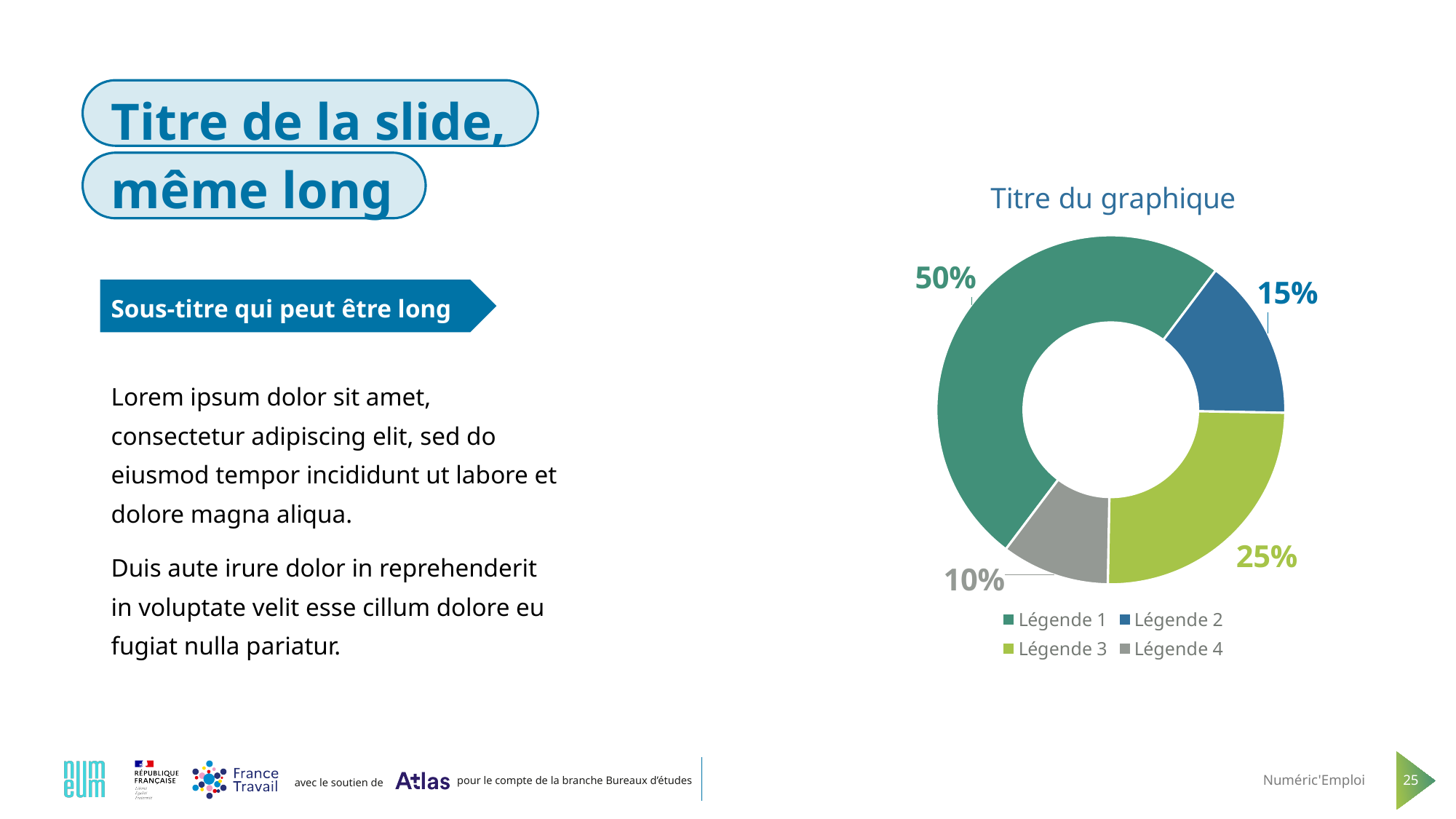
What colour is the slice for Légende 4? Grey What is the value for Légende 2? 15% Which is larger, the value for Légende 2 or the value for Légende 3? Légende 3 Which category has the largest share of the chart? Légende 1 What is the title of the chart? Titre du graphique What type of chart is shown on the slide? Doughnut chart Which category has the smallest share of the chart? Légende 4 What is the value for Légende 4? 10% What is the value for Légende 1? 50% What is the difference between the values for Légende 1 and Légende 3? 25% How many categories does the legend list? 4 What is the value for Légende 3? 25%